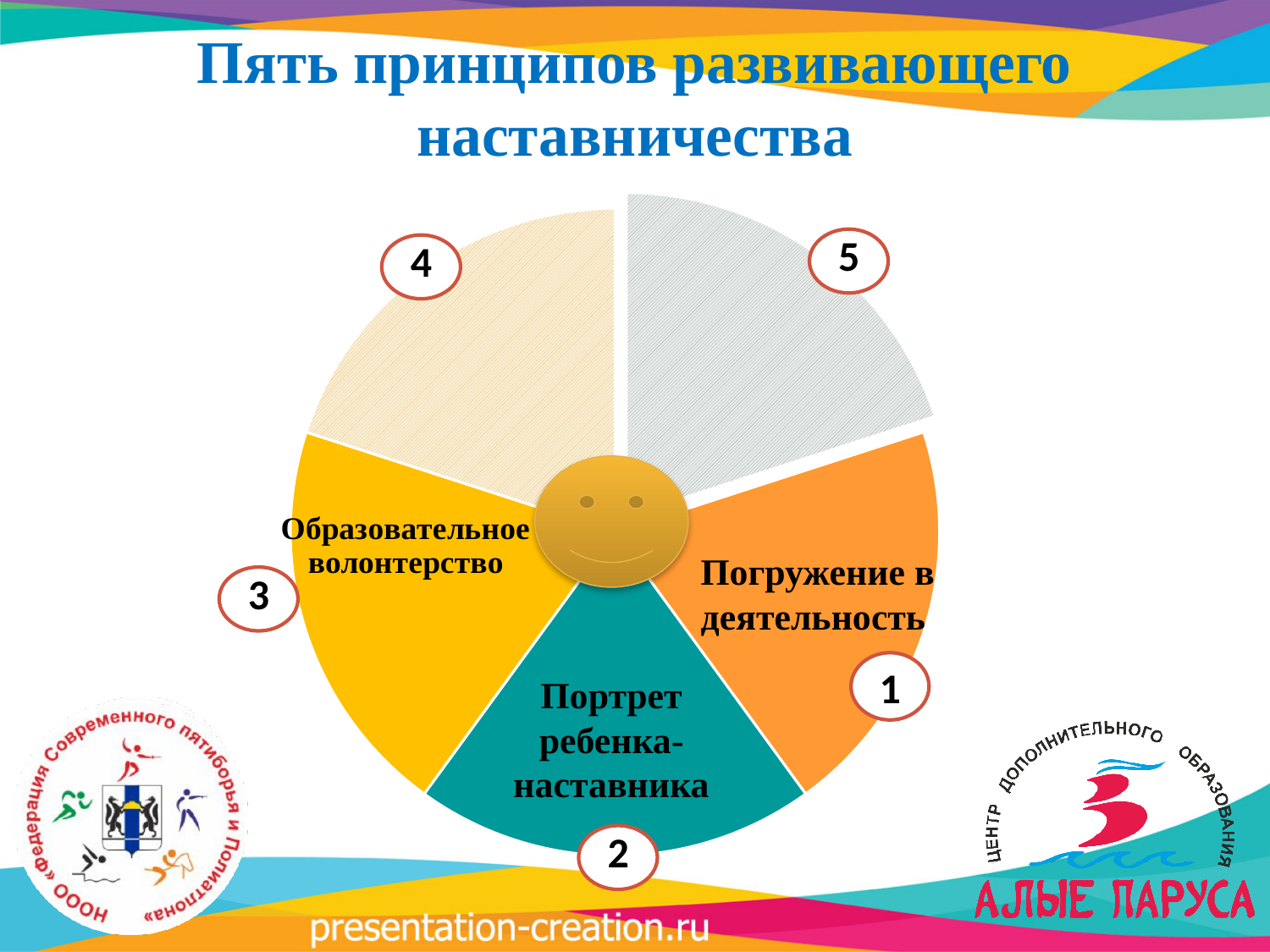
What number is shown next to the slice labelled 'Портрет ребенка-наставника'? 2 Which slice of the pie chart is labelled with the number 1? Погружение в деятельность Which slice of the pie chart is labelled with the number 3? Образовательное волонтерство What colour is the slice labelled 'Портрет ребенка-наставника'? teal Which slice of the pie chart is labelled with the number 2? Портрет ребенка-наставника How many slices of the pie chart have a text label (other than a number)? 3 How many slices does the pie chart have? 5 What number is shown next to the slice labelled 'Образовательное волонтерство'? 3 What kind of chart is shown on the slide? pie chart What is the title of the slide containing the pie chart? Пять принципов развивающего наставничества